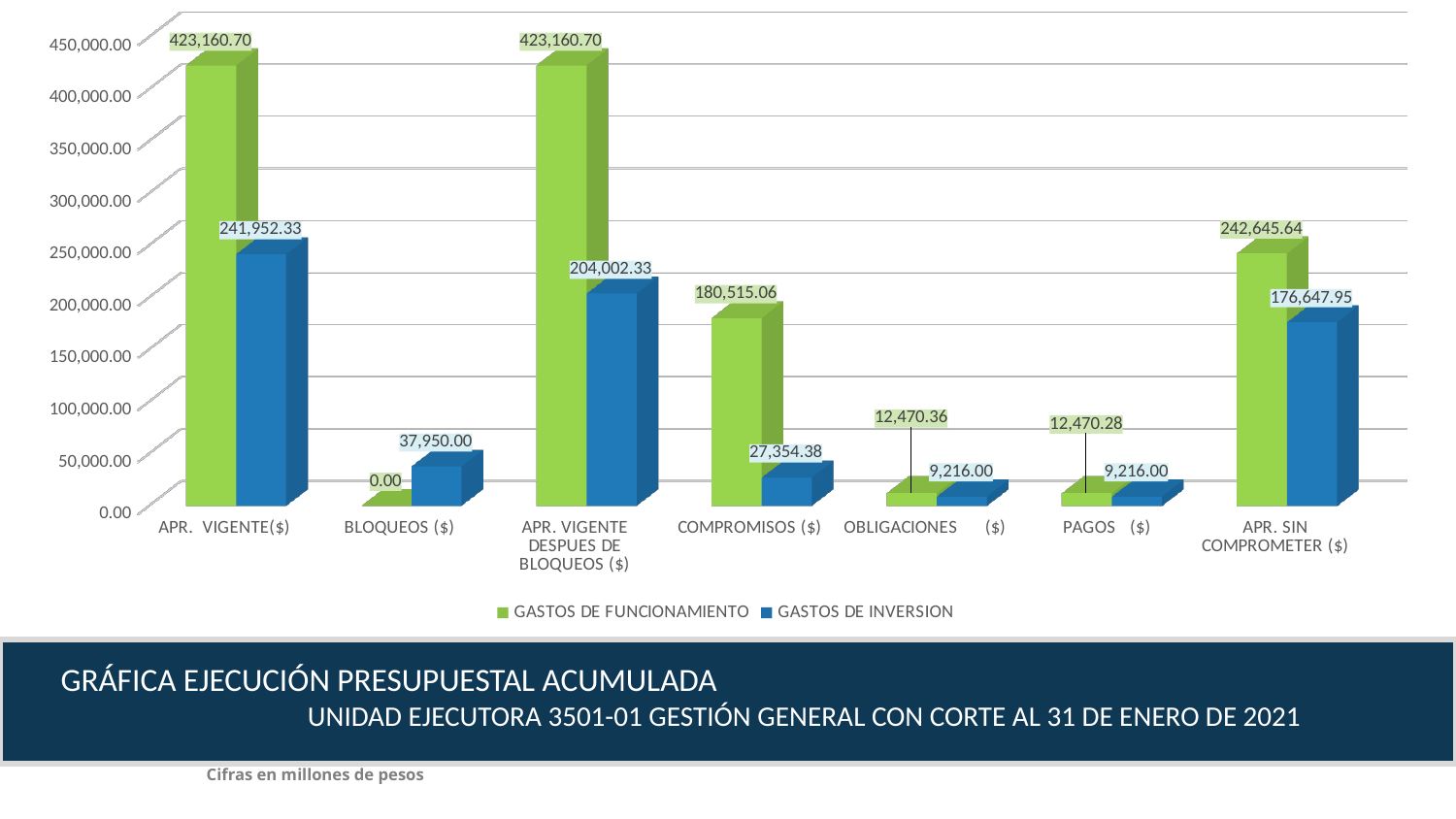
What is the difference between GASTOS DE FUNCIONAMIENTO and GASTOS DE INVERSION for APR. VIGENTE($)? 181,208.37 Which category has the highest value for GASTOS DE INVERSION? APR. VIGENTE($) What is the value of GASTOS DE INVERSION for COMPROMISOS ($)? 27,354.38 Which category has the lowest value for GASTOS DE FUNCIONAMIENTO? BLOQUEOS ($) Which is larger for BLOQUEOS ($): GASTOS DE FUNCIONAMIENTO or GASTOS DE INVERSION? GASTOS DE INVERSION What is the value of GASTOS DE FUNCIONAMIENTO for APR. VIGENTE($)? 423,160.70 What is the difference between GASTOS DE FUNCIONAMIENTO and GASTOS DE INVERSION for APR. SIN COMPROMETER ($)? 65,997.69 What kind of chart is shown on the slide? Bar chart What is the value of GASTOS DE FUNCIONAMIENTO for APR. SIN COMPROMETER ($)? 242,645.64 What is the value of GASTOS DE INVERSION for BLOQUEOS ($)? 37,950.00 How many series does the legend list? 2 How many categories are shown on the x axis? 7